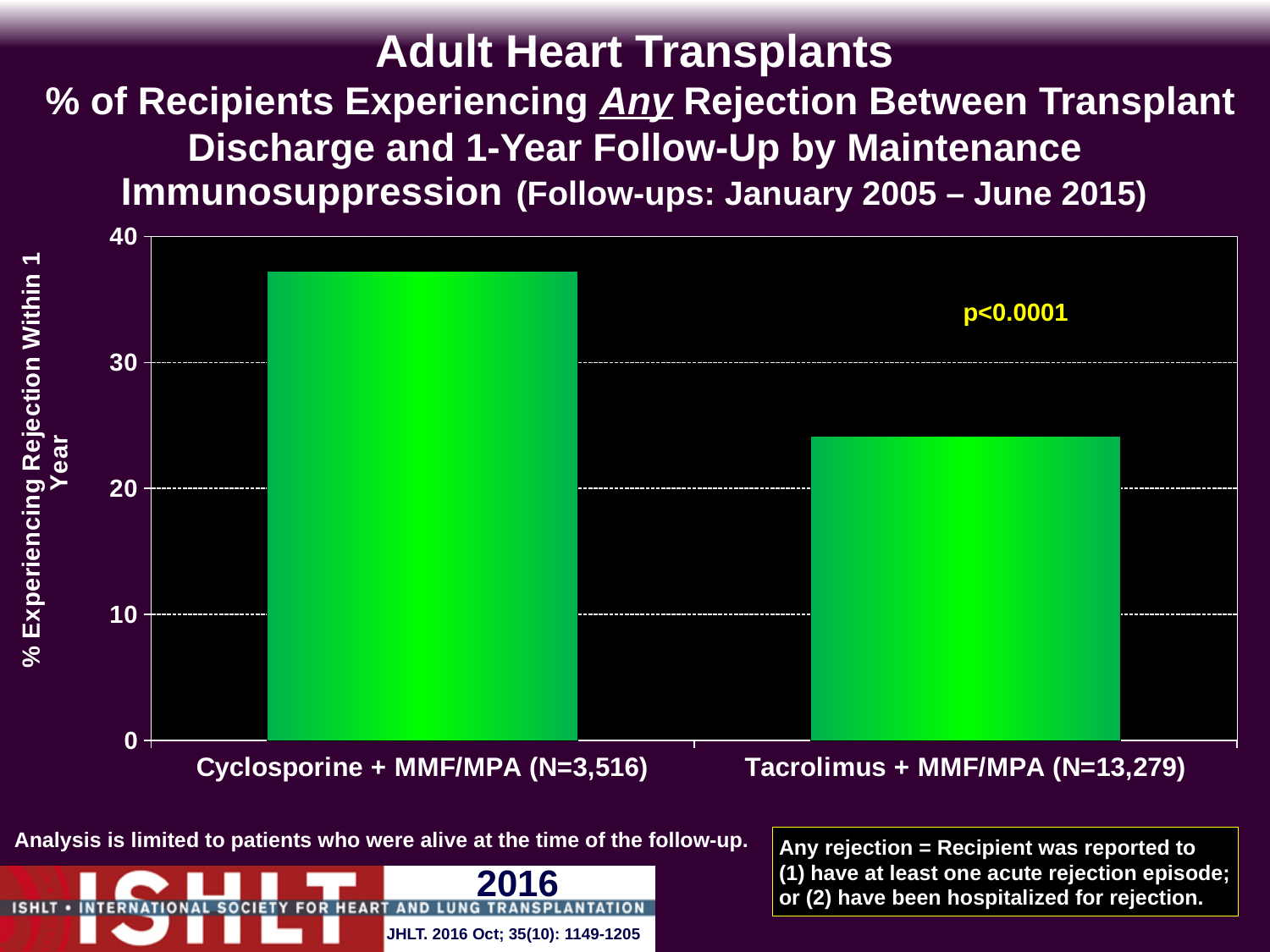
Is the value for Tacrolimus + MMF/MPA greater or less than 20? greater What is the label of the y-axis of the chart? % Experiencing Rejection Within 1 Year Is the value for Cyclosporine + MMF/MPA greater or less than 40? less Which maintenance immunosuppression group has the lower percentage of recipients experiencing rejection within 1 year? Tacrolimus + MMF/MPA (N=13,279) Which maintenance immunosuppression group has the higher percentage of recipients experiencing rejection within 1 year? Cyclosporine + MMF/MPA (N=3,516) How many categories (bars) are plotted in the chart? 2 What is the maximum value shown on the y-axis? 40 Is the value for Cyclosporine + MMF/MPA greater or less than 30? greater What kind of chart is shown on the slide? bar chart What p-value is shown on the chart? p<0.0001 Which is larger: the value for Cyclosporine + MMF/MPA or the value for Tacrolimus + MMF/MPA? Cyclosporine + MMF/MPA